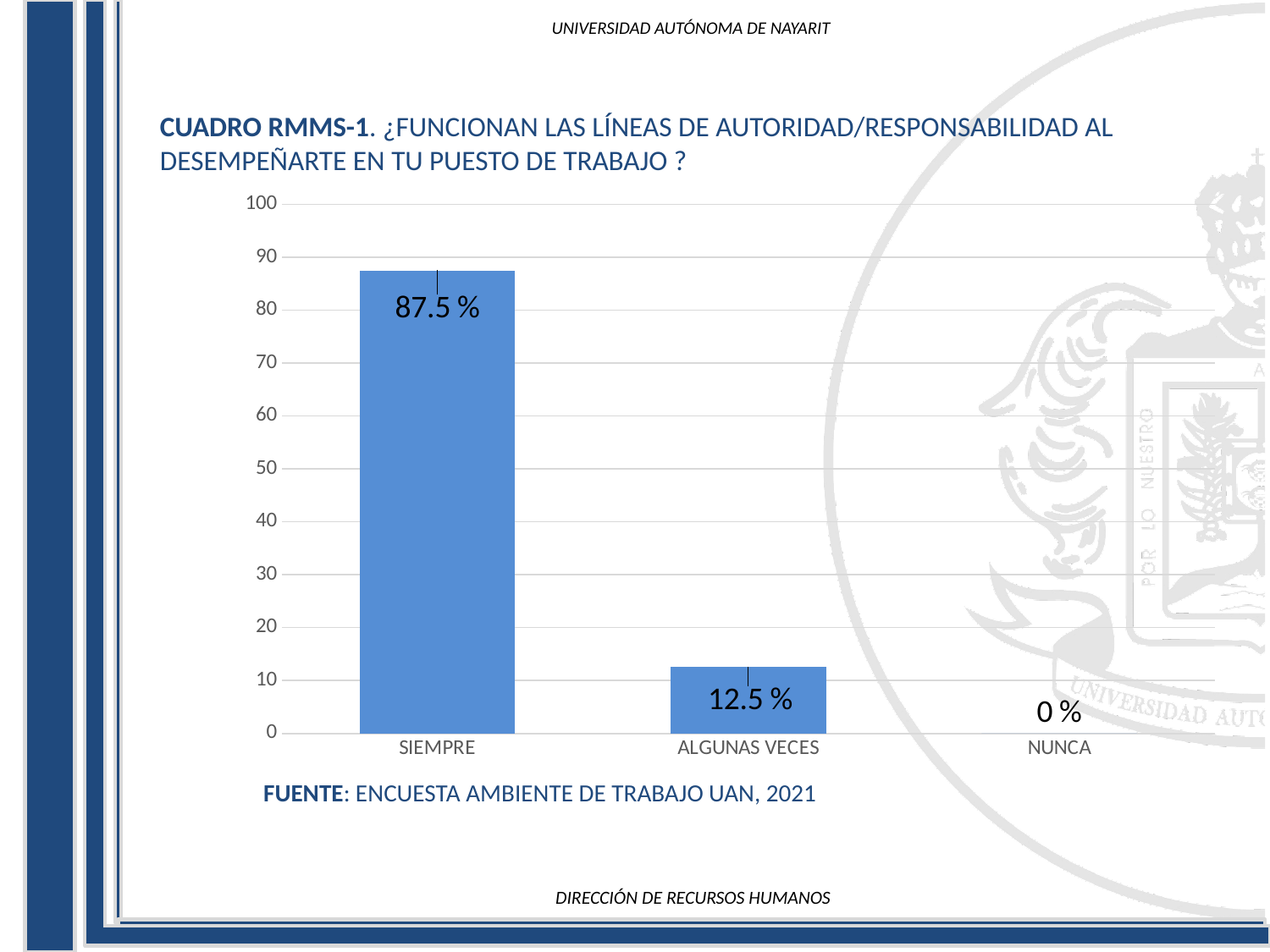
What is the value for ALGUNAS VECES? 12.5 % What is the value for SIEMPRE? 87.5 % Is the value for ALGUNAS VECES greater or less than 20? less Which is larger, the value for ALGUNAS VECES or the value for NUNCA? ALGUNAS VECES Which category has the lowest value? NUNCA What source is cited below the chart? ENCUESTA AMBIENTE DE TRABAJO UAN, 2021 What is the difference between the values for SIEMPRE and ALGUNAS VECES? 75 % Is the value for SIEMPRE greater or less than 80? greater How many categories are shown on the x axis? 3 What is the value for NUNCA? 0 % What kind of chart is shown on the slide? bar chart Which category has the highest value? SIEMPRE